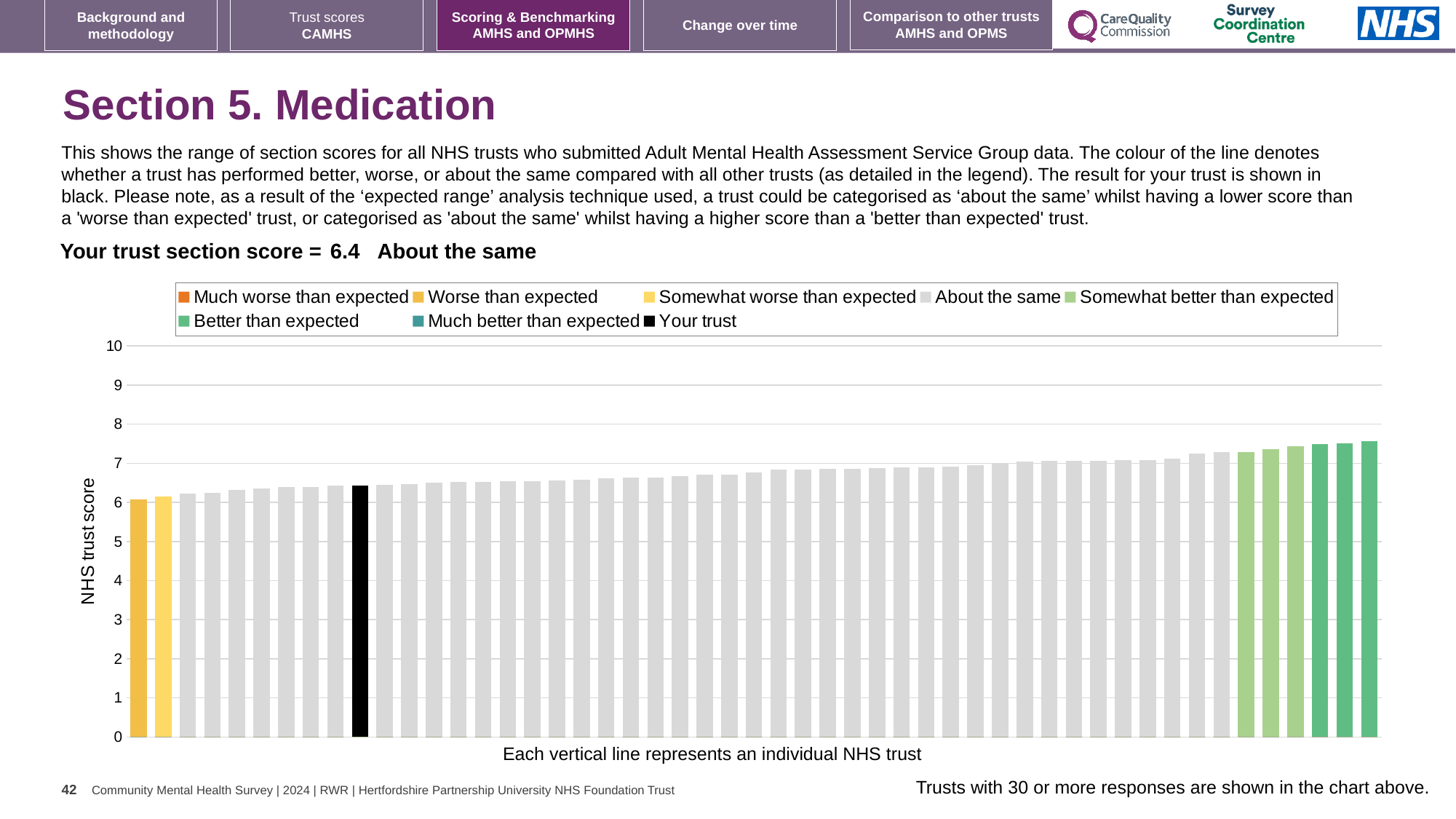
What is the label on the y axis of the chart? NHS trust score What colour is used in the chart for 'Your trust'? Black How many entries does the chart legend list? 8 Is the value of the black 'Your trust' bar greater or less than 6? greater What is the section score for your trust shown on the slide? 6.4 Which category is your trust placed in for this section? About the same Do the bar values rise or fall moving from left to right along the x axis? rise Which is larger: the black 'Your trust' bar or the leftmost bar? The black 'Your trust' bar Is the value of the leftmost bar greater or less than 7? less What kind of chart is shown on the slide? Bar chart Is the value of the black 'Your trust' bar greater or less than 7? less